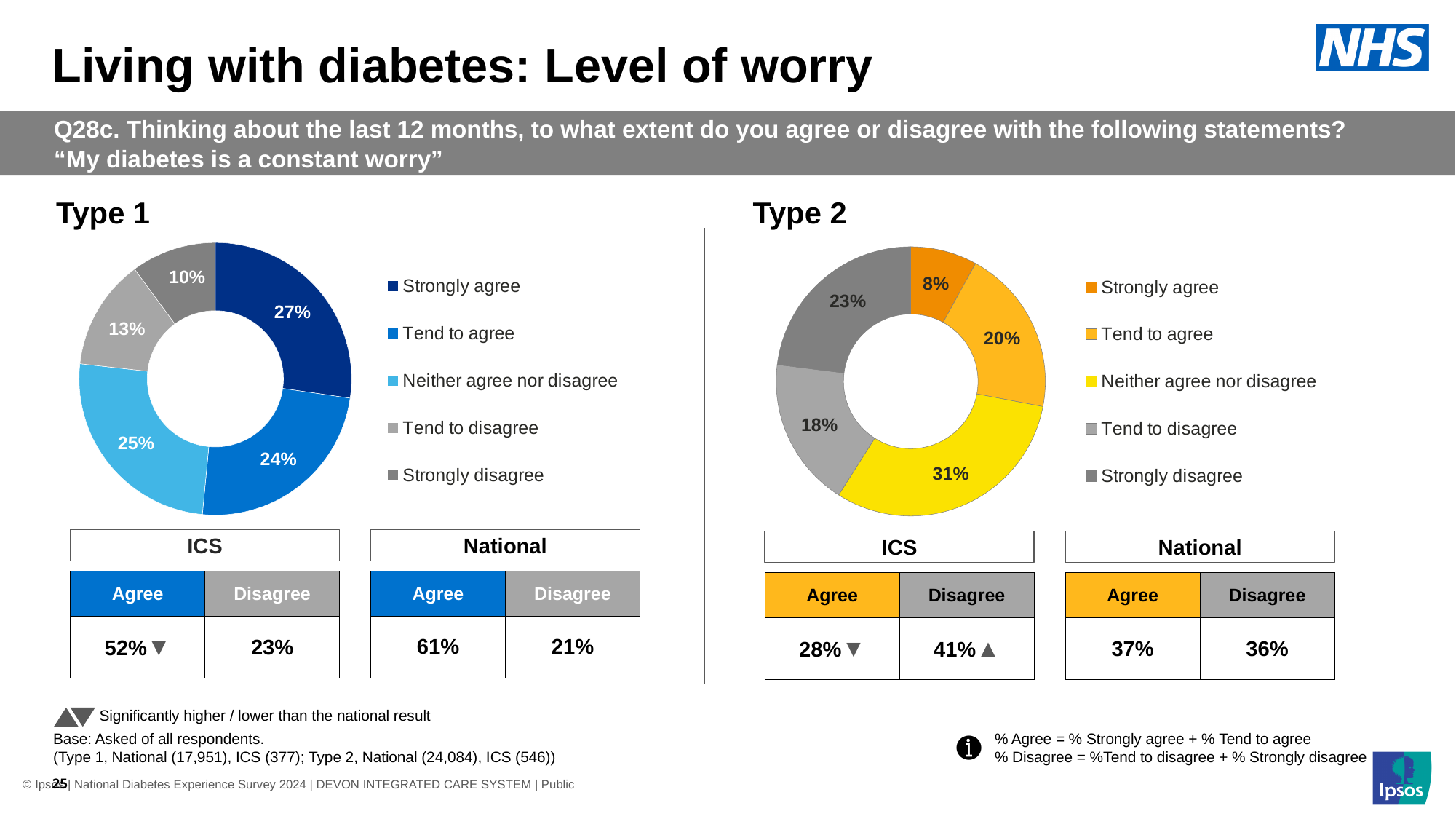
What kind of chart is used to show the Type 1 results? Donut (pie) chart In the Type 1 chart, what percentage of respondents said they strongly agree? 27% In the Type 1 chart, which response category has the smallest share? Strongly disagree In the Type 2 chart, what percentage of respondents said they neither agree nor disagree? 31% How many response categories does the legend of the Type 2 chart list? 5 In the Type 1 chart, which is larger: the Strongly agree share or the Tend to disagree share? Strongly agree In the Type 1 chart, what colour is the Strongly agree segment? Dark blue In the Type 2 chart, which response category has the smallest share? Strongly agree In the Type 2 chart, what is the difference between the Strongly disagree share and the Strongly agree share? 15% In the Type 2 chart, what percentage of respondents said they strongly disagree? 23% In the Type 2 chart, which response category has the largest share? Neither agree nor disagree In the Type 1 chart, what is the difference between the Tend to agree share and the Tend to disagree share? 11%